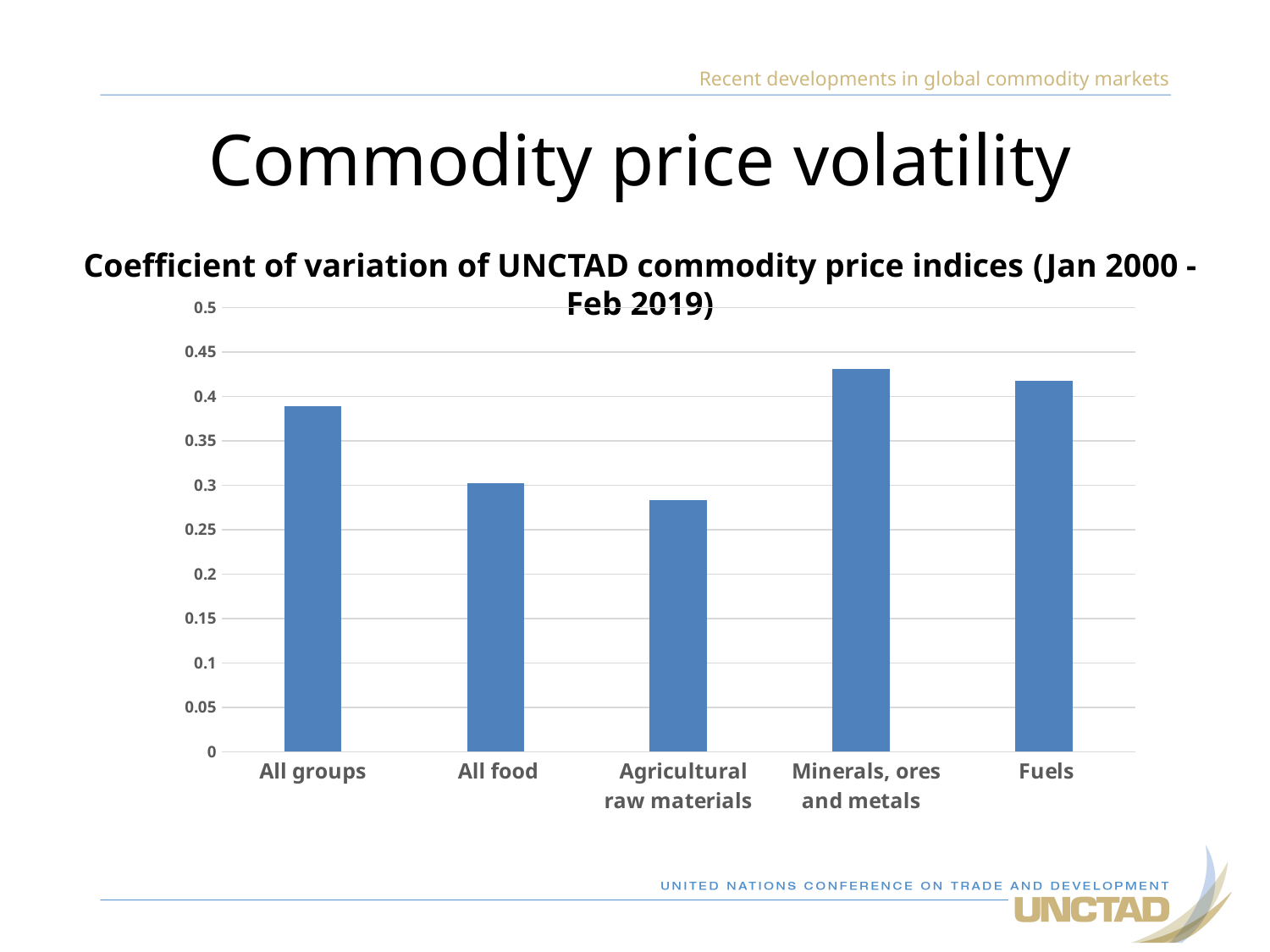
Is the value for Agricultural raw materials greater or less than 0.3? less Is the value for Fuels greater or less than 0.4? greater How many categories are plotted on the chart? 5 Which category has the lowest coefficient of variation? Agricultural raw materials Which category has the highest coefficient of variation? Minerals, ores and metals Is the value for All food greater or less than 0.35? less What kind of chart is shown on the slide? Bar chart Which is larger, the value for Minerals, ores and metals or the value for Agricultural raw materials? Minerals, ores and metals What is the title of the chart? Coefficient of variation of UNCTAD commodity price indices (Jan 2000 - Feb 2019) Which is larger, the value for All groups or the value for All food? All groups